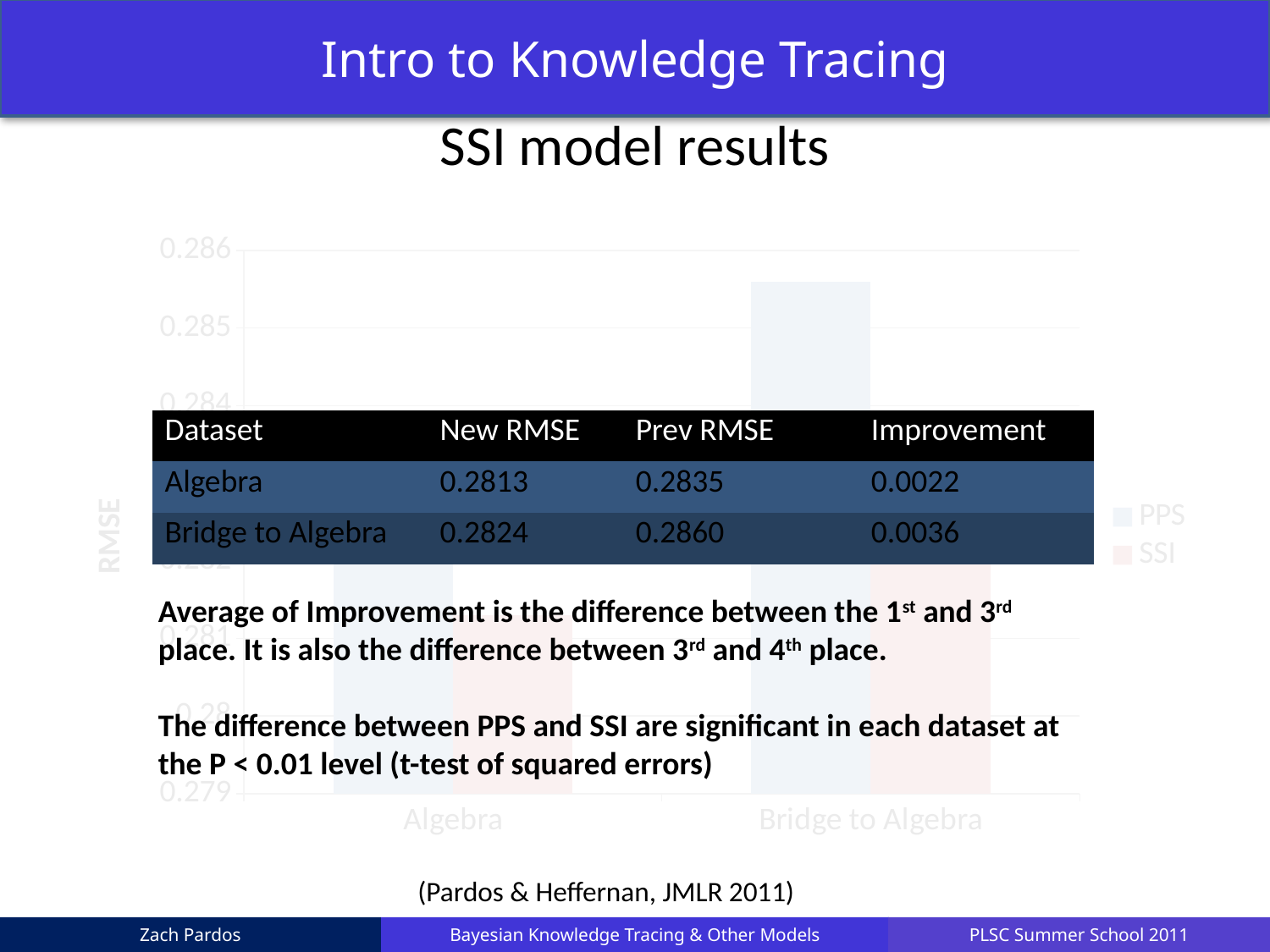
How many series does the chart's legend list? 2 What is the label on the chart's y axis? RMSE What is the lowest value shown on the chart's y axis? 0.279 Is the PPS value for Bridge to Algebra greater or less than 0.285? greater What kind of chart is shown on the slide? bar chart Is the PPS value for Algebra greater or less than 0.285? less What are the two series named in the chart's legend? PPS and SSI Which category has the higher PPS value in the chart? Bridge to Algebra Is the SSI value for Bridge to Algebra greater or less than 0.285? less How many categories are shown on the x axis of the chart? 2 For Bridge to Algebra, which series has the larger value, PPS or SSI? PPS